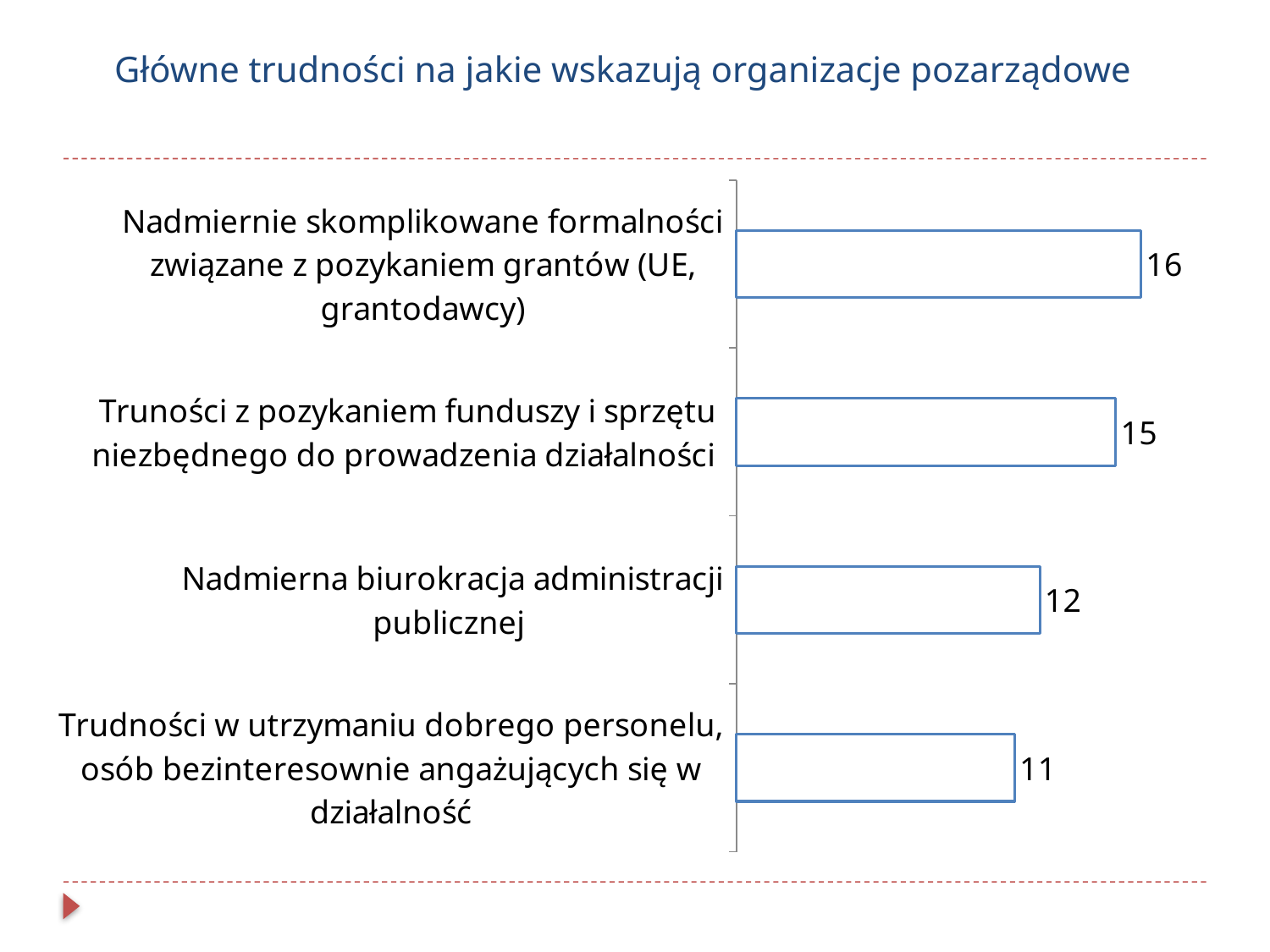
Which category has the lowest value? Trudności w utrzymaniu dobrego personelu, osób bezinteresownie angażujących się w działalność What is the value for "Trudności w utrzymaniu dobrego personelu, osób bezinteresownie angażujących się w działalność"? 11 What kind of chart is shown on the slide? Bar chart What is the value for "Nadmiernie skomplikowane formalności związane z pozykaniem grantów (UE, grantodawcy)"? 16 What is the value for "Truności z pozykaniem funduszy i sprzętu niezbędnego do prowadzenia działalności"? 15 What is the difference between the value for "Truności z pozykaniem funduszy i sprzętu niezbędnego do prowadzenia działalności" and the value for "Trudności w utrzymaniu dobrego personelu, osób bezinteresownie angażujących się w działalność"? 4 Which category has the highest value? Nadmiernie skomplikowane formalności związane z pozykaniem grantów (UE, grantodawcy) Which is larger: the value for "Nadmierna biurokracja administracji publicznej" or the value for "Trudności w utrzymaniu dobrego personelu, osób bezinteresownie angażujących się w działalność"? Nadmierna biurokracja administracji publicznej What is the difference between the value for "Nadmiernie skomplikowane formalności związane z pozykaniem grantów (UE, grantodawcy)" and the value for "Nadmierna biurokracja administracji publicznej"? 4 How many categories are shown in the chart? 4 What is the title of the slide? Główne trudności na jakie wskazują organizacje pozarządowe What is the value for "Nadmierna biurokracja administracji publicznej"? 12